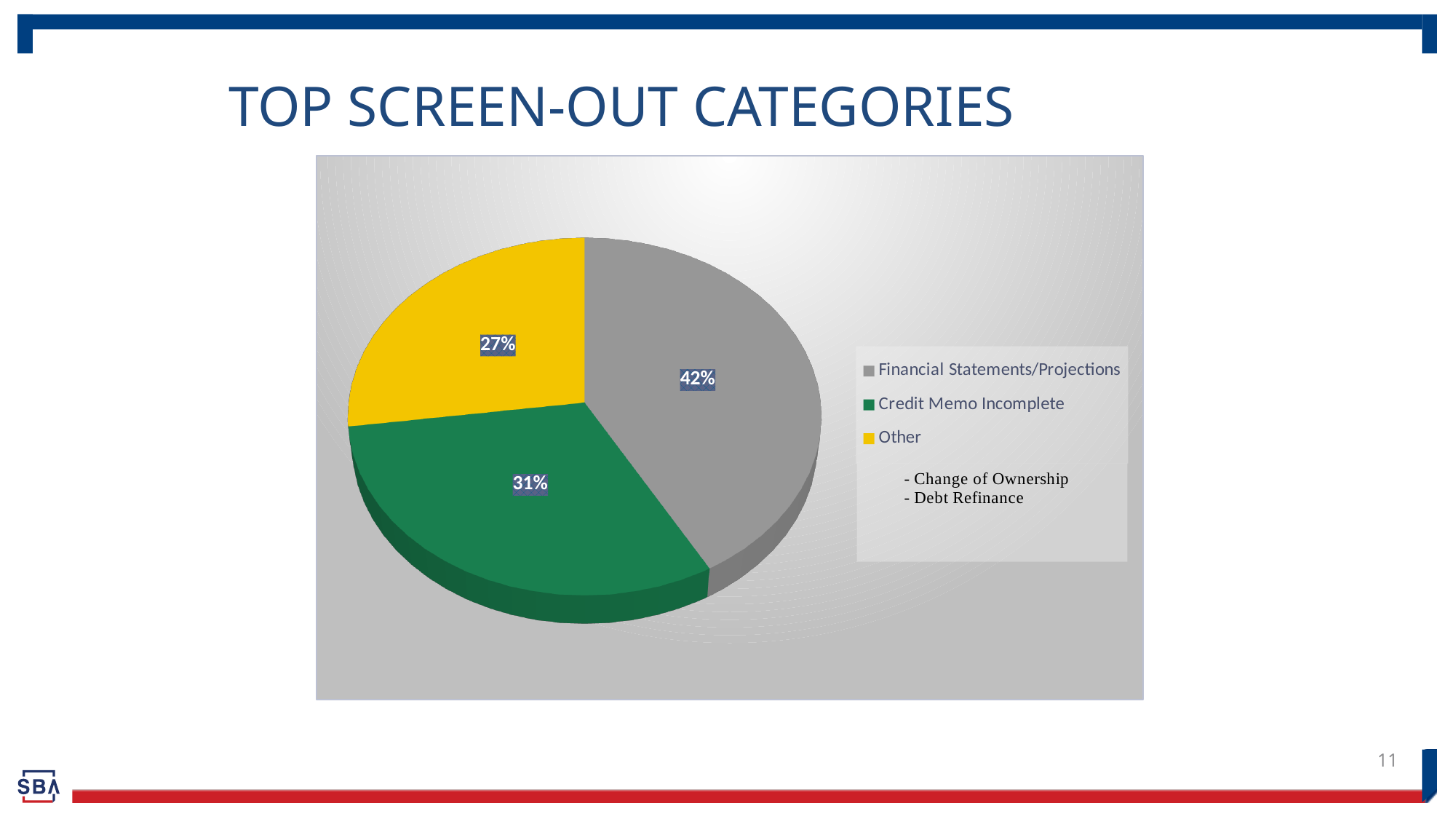
What colour is the slice for Credit Memo Incomplete? Green What is the title of the slide containing the pie chart? TOP SCREEN-OUT CATEGORIES What is the difference in percentage points between Financial Statements/Projections and Credit Memo Incomplete? 11 What is the difference in percentage points between Credit Memo Incomplete and Other? 4 Which category has the smallest share of the pie? Other Which category has the largest share of the pie? Financial Statements/Projections What share of the pie does Other represent? 27% What type of chart is shown on the slide? Pie chart Which is larger, the share for Credit Memo Incomplete or the share for Other? Credit Memo Incomplete What share of the pie does Credit Memo Incomplete represent? 31% How many categories are shown in the pie chart? 3 What share of the pie does Financial Statements/Projections represent? 42%